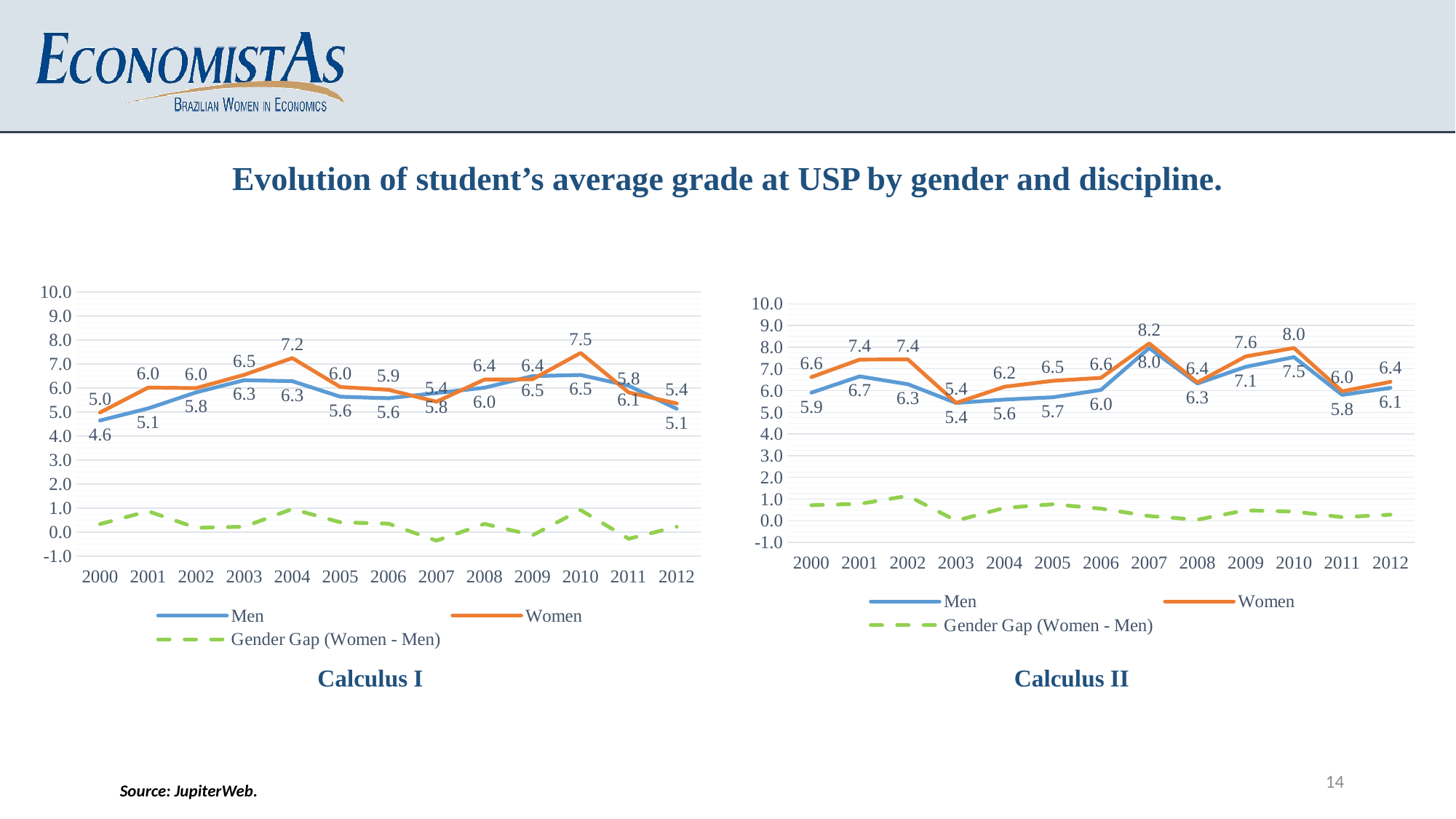
In the Calculus II chart, what was the average grade for Men in 2003? 5.4 In the Calculus I chart, in which year was the Men's average grade lowest? 2000 In the Calculus I chart, which group had the higher average grade in 2012, Men or Women? Women In the Calculus II chart, what is the difference between the Women's and Men's average grades in 2010? 0.5 In the Calculus I chart, what was the average grade for Women in 2004? 7.2 In the Calculus I chart, in which year was the Women's average grade highest? 2010 How many series does the legend of the Calculus II chart list? 3 In the Calculus I chart, what was the average grade for Men in 2000? 4.6 In the Calculus II chart, in which year was the Women's average grade highest? 2007 In the Calculus II chart, what was the average grade for Women in 2007? 8.2 In the Calculus I chart, what is the difference between the Women's and Men's average grades in 2004? 0.9 What type of chart is the Calculus I chart? Line chart